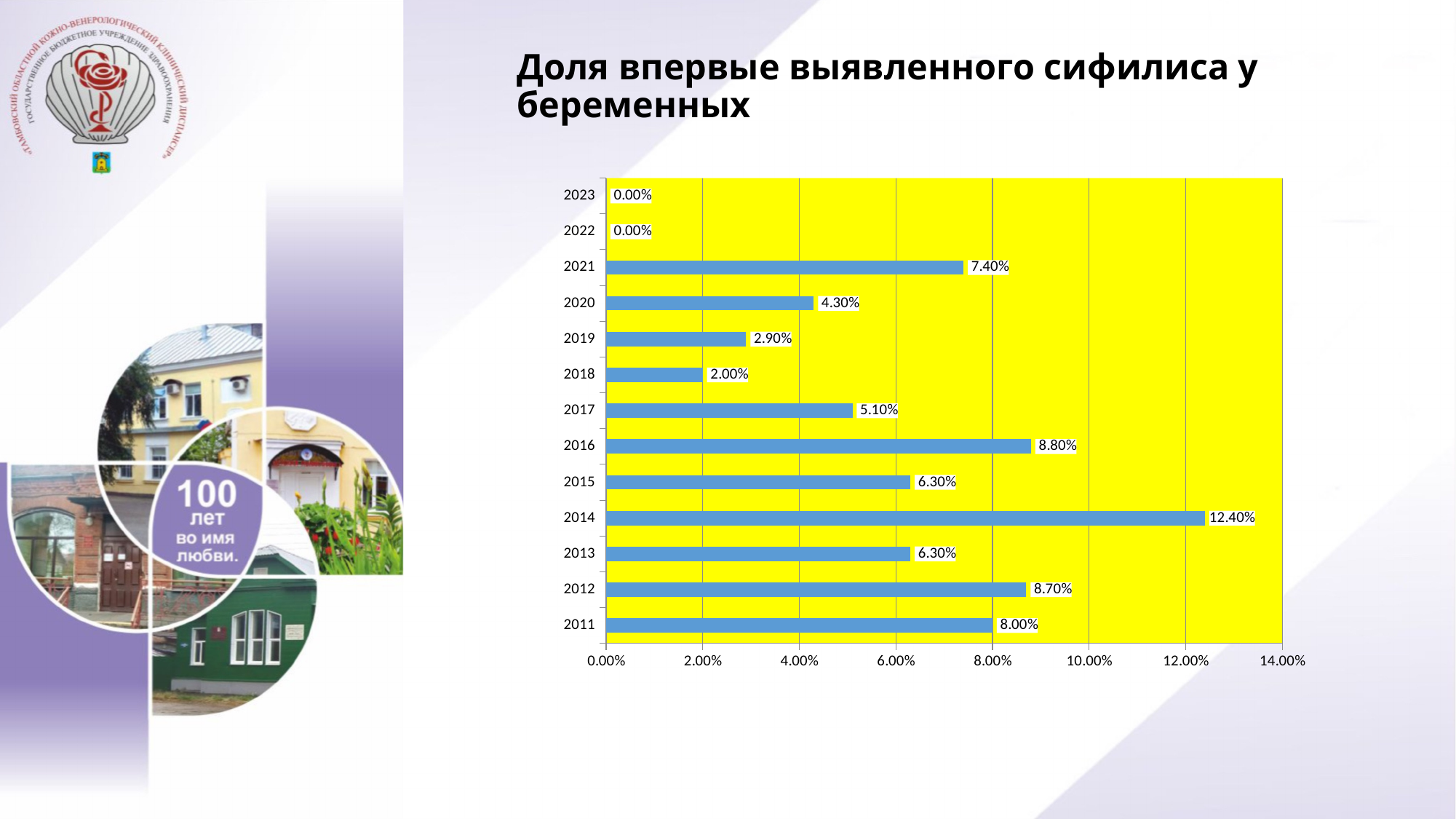
What is the difference between the values for 2014 and 2016? 3.60% What is the value for 2021? 7.40% What is the value for 2018? 2.00% What is the difference between the values for 2012 and 2011? 0.70% Which is larger, the value for 2017 or the value for 2020? 2017 Which years have a value of 0.00%? 2022 and 2023 What is the value for 2014? 12.40% What is the title of the chart? Доля впервые выявленного сифилиса у беременных How many years are shown on the chart? 13 Is the value for 2016 greater or less than 8.00%? greater What kind of chart is shown on the slide? Bar chart Which year has the highest value? 2014